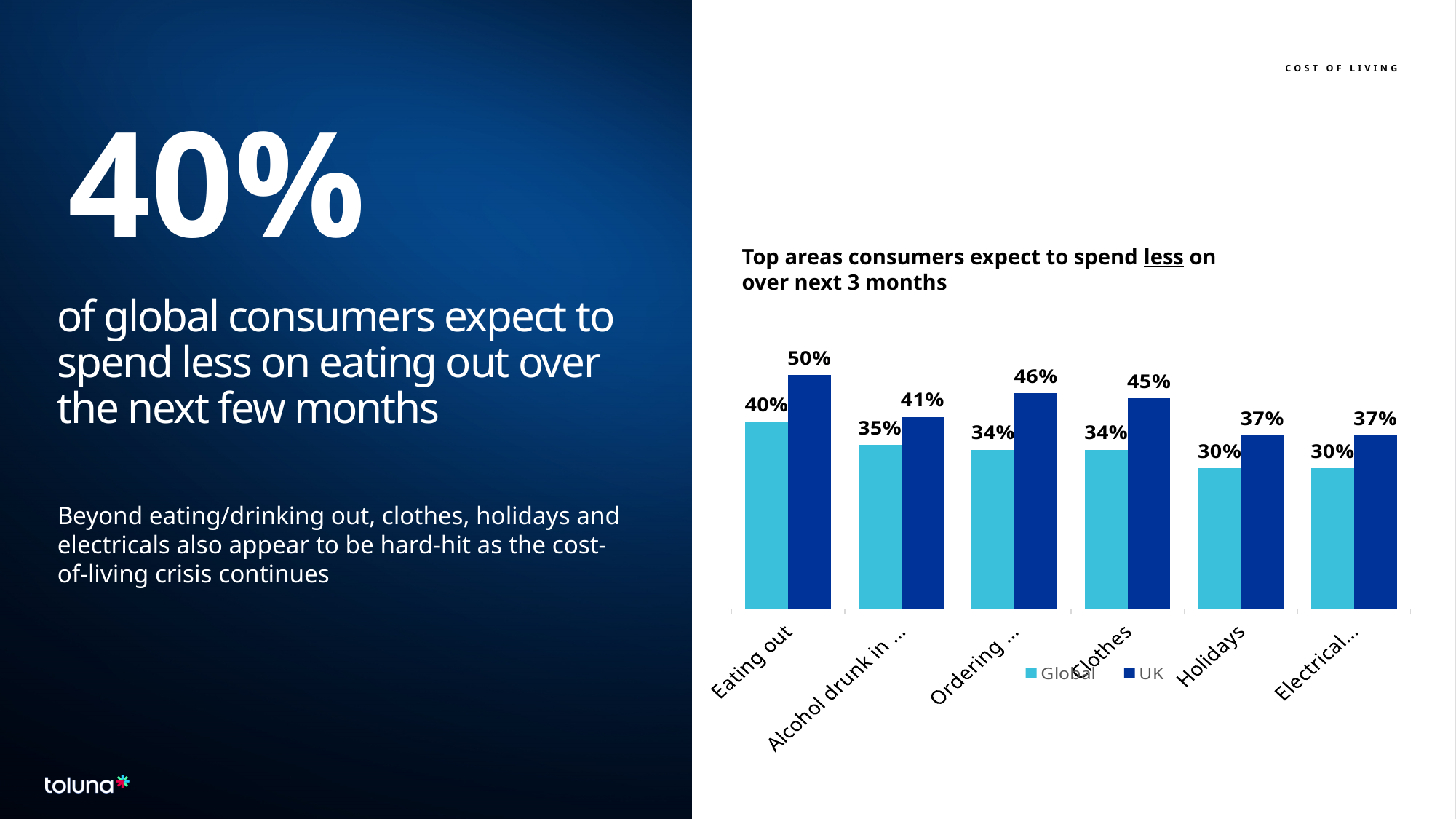
Which category has the highest Global value? Eating out What kind of chart is shown on the slide? Bar chart What is the Global value for Eating out? 40% Which is larger for Clothes, the Global value or the UK value? UK What is the UK value for Holidays? 37% What is the difference between the UK and Global values for Clothes? 11% What is the Global value for Holidays? 30% What is the difference between the UK and Global values for Eating out? 10% Which category has the highest UK value? Eating out What is the UK value for Clothes? 45% How many series does the legend list? 2 What is the UK value for Eating out? 50%